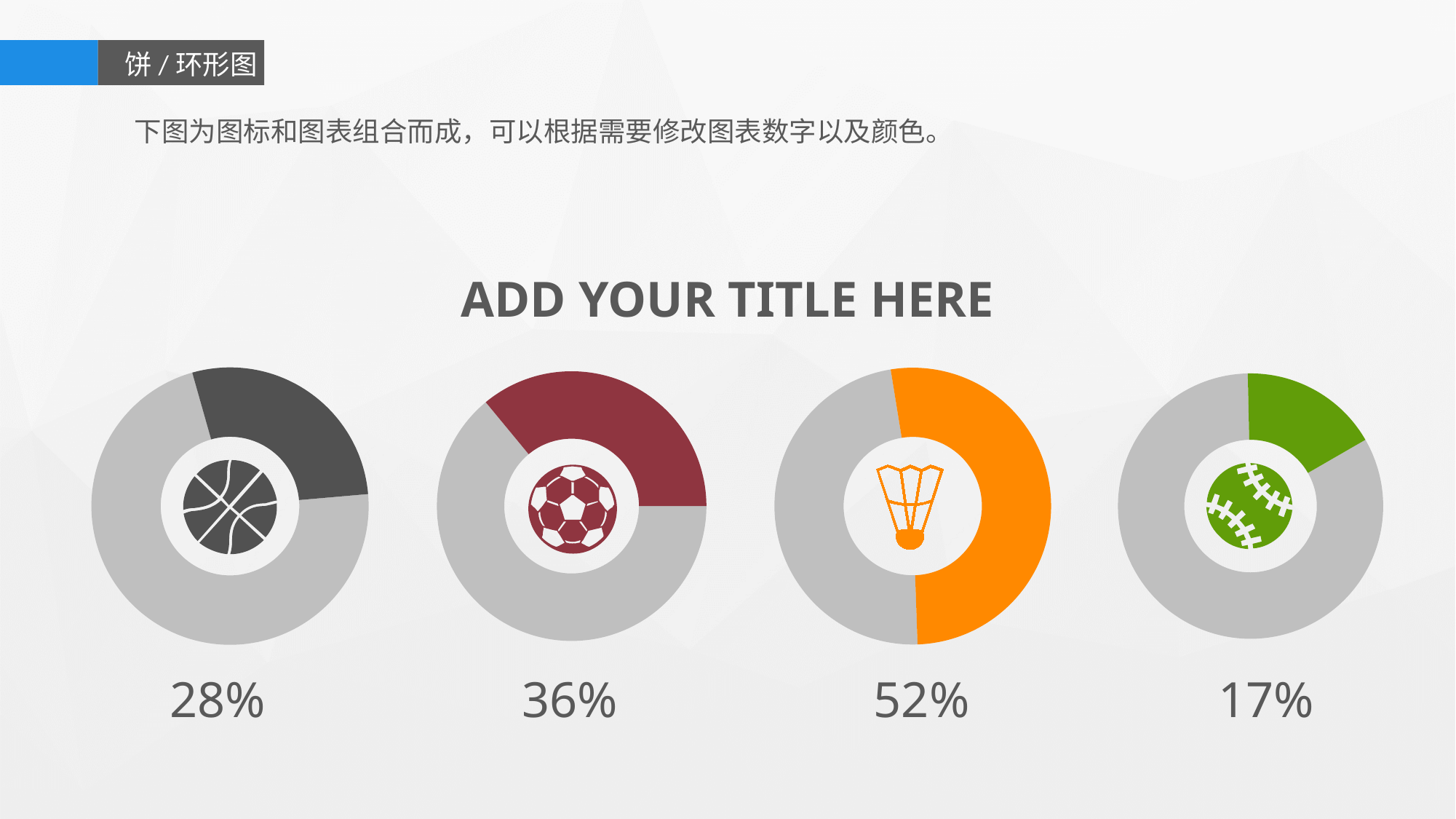
What type of chart is used for each of the four figures on the slide? Donut (ring) chart How many donut charts are shown on the slide? 4 Which of the four donut charts shows the highest percentage? The shuttlecock (third) chart, 52% What is the difference between the percentage of the shuttlecock chart and the baseball chart? 35% What percentage is shown below the first (leftmost) donut chart with the basketball icon? 28% What percentage is shown below the fourth (rightmost) donut chart with the baseball icon? 17% What is the difference between the percentage of the soccer ball chart and the basketball chart? 8% What percentage is shown below the second donut chart with the soccer ball icon? 36% Which of the four donut charts shows the lowest percentage? The baseball (fourth) chart, 17% What percentage is shown below the third donut chart with the shuttlecock icon? 52% Which is larger, the percentage of the basketball chart or the soccer ball chart? The soccer ball chart What colour is the filled segment of the third donut chart with the shuttlecock icon? Orange